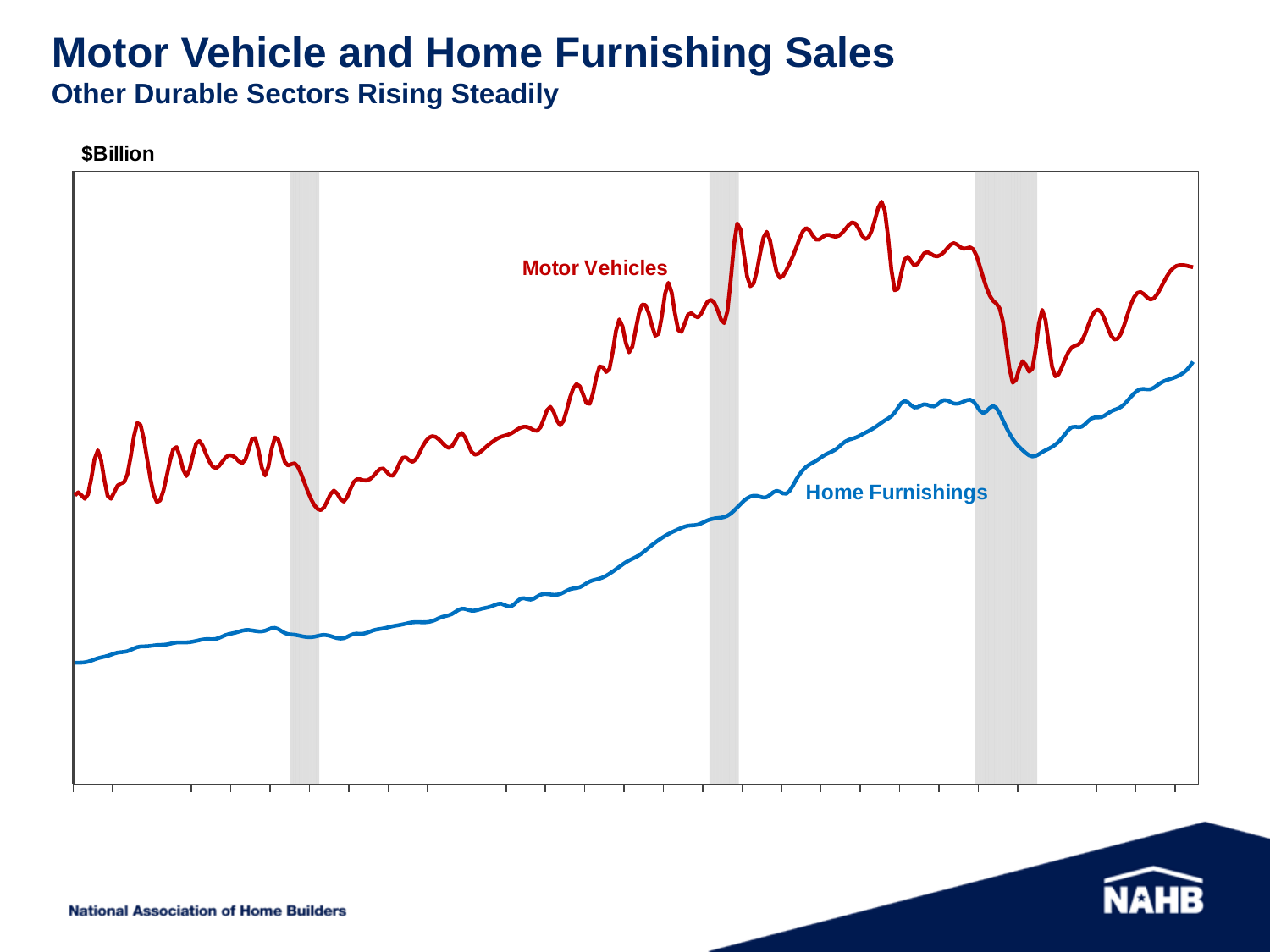
Which series is plotted higher on the chart throughout, Motor Vehicles or Home Furnishings? Motor Vehicles Does the Motor Vehicles line end higher or lower at the right edge of the chart than it starts at the left edge? higher At the right end of the chart, which series has the lower value, Motor Vehicles or Home Furnishings? Home Furnishings Within the rightmost shaded band, does the Home Furnishings line rise or fall? fall What kind of chart is shown on the slide? line chart What unit label is shown above the chart's vertical axis? $Billion What is the title of the chart on the slide? Motor Vehicle and Home Furnishing Sales Within the rightmost shaded band, does the Motor Vehicles line rise or fall? fall How many data series are plotted on the chart? 2